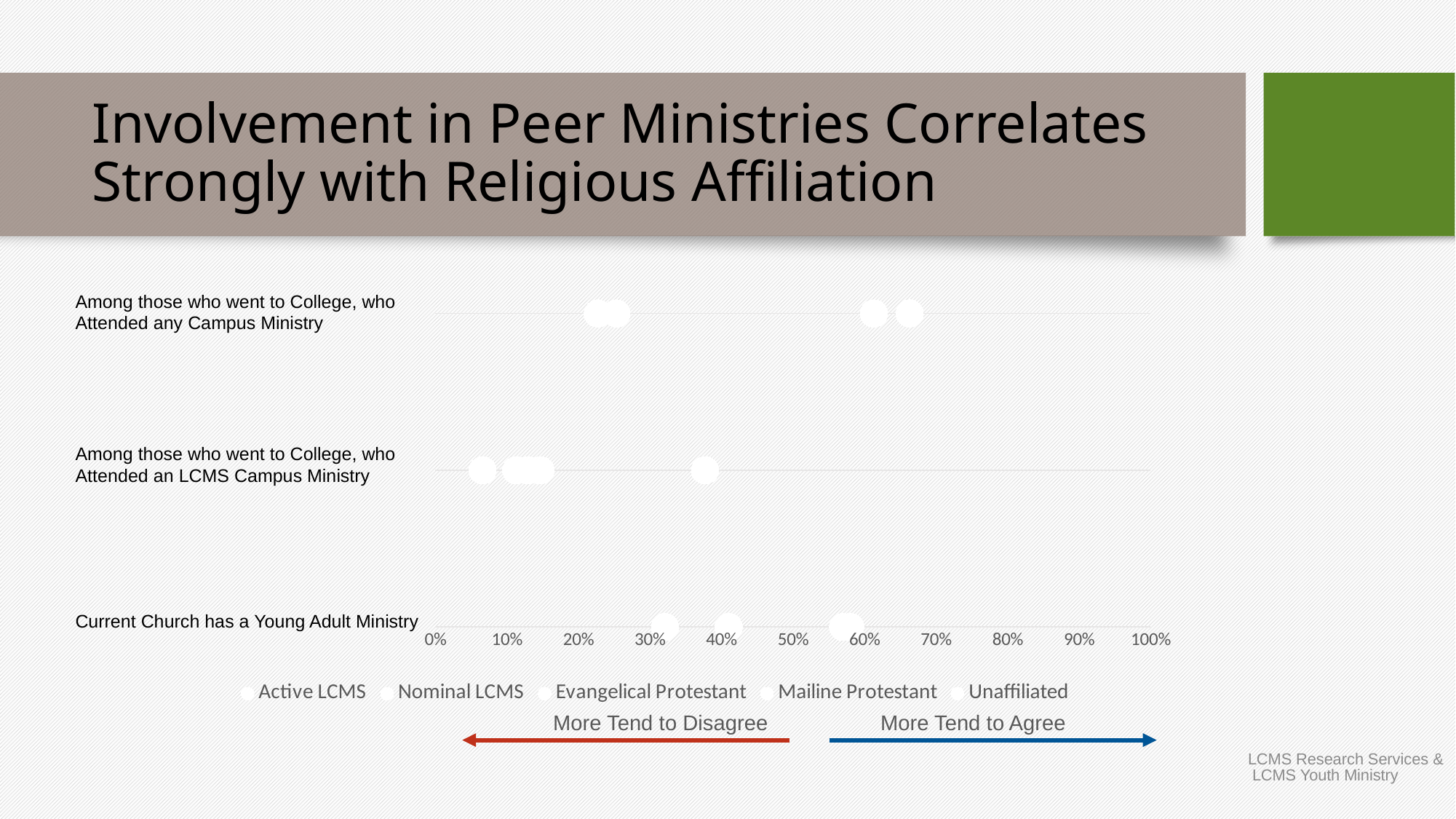
What is the label of the category plotted at the bottom of the chart? Current Church has a Young Adult Ministry In the row 'Among those who went to College, who Attended any Campus Ministry', is the highest plotted value greater or less than 60%? greater How many series does the chart legend list? 5 In the row 'Among those who went to College, who Attended an LCMS Campus Ministry', is the highest plotted value greater or less than 50%? less Which row has the highest plotted value overall: 'Attended any Campus Ministry' or 'Attended an LCMS Campus Ministry'? Among those who went to College, who Attended any Campus Ministry What is the range of the horizontal axis on the chart? 0% to 100% In the row 'Among those who went to College, who Attended any Campus Ministry', is the lowest plotted value greater or less than 30%? less What are the series names listed in the chart legend? Active LCMS, Nominal LCMS, Evangelical Protestant, Mailine Protestant, Unaffiliated How many categories (rows) are plotted on the chart? 3 What kind of chart is shown on the slide? Dot plot (scatter chart)